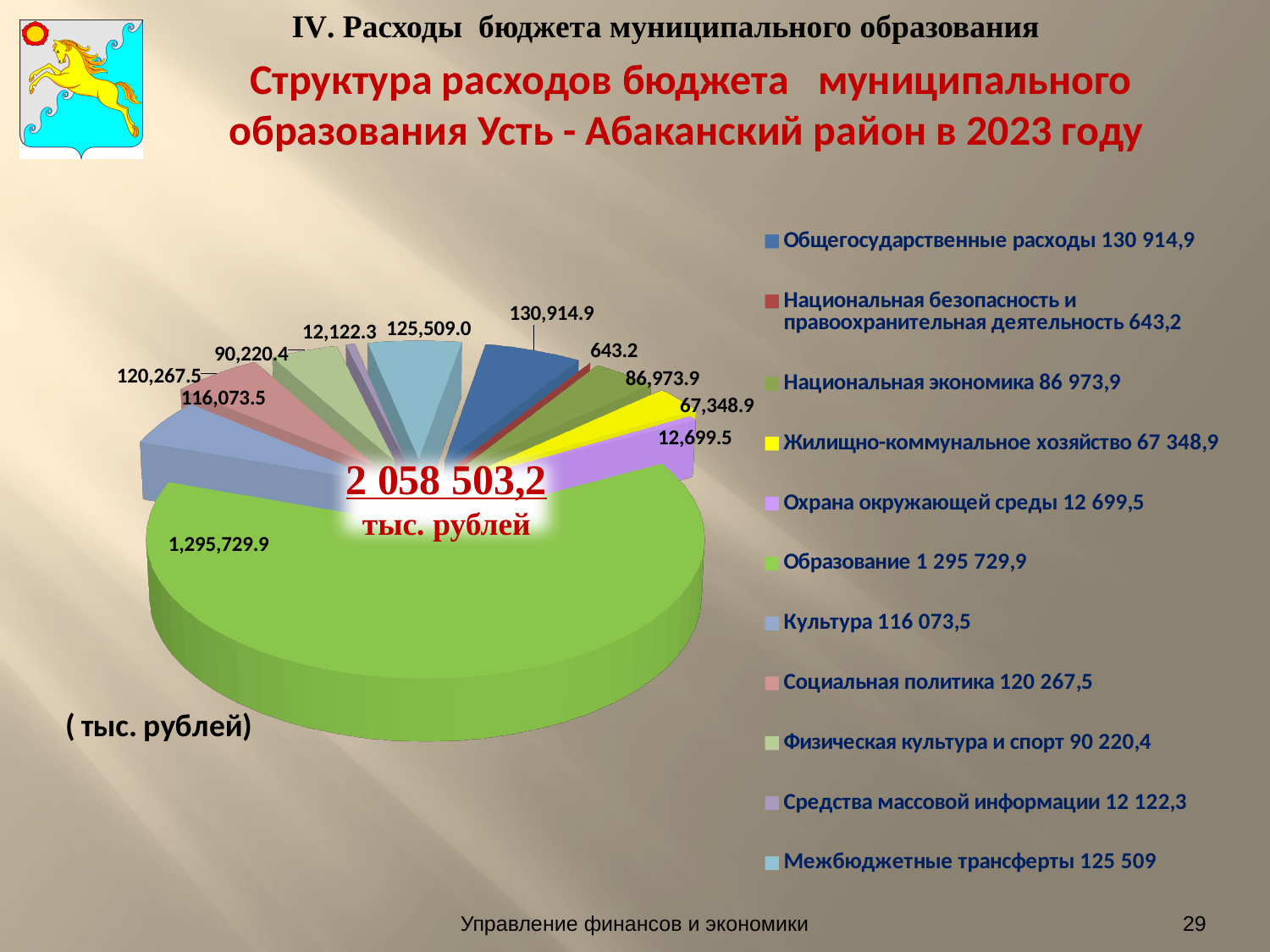
What is the difference between Социальная политика and Культура? 4,194.0 How many categories does the pie chart have? 11 What is the value for Жилищно-коммунальное хозяйство? 67,348.9 Which is larger, Физическая культура и спорт or Национальная экономика? Физическая культура и спорт What is the value for Национальная безопасность и правоохранительная деятельность? 643.2 Which category has the smallest value? Национальная безопасность и правоохранительная деятельность What is the value for Средства массовой информации? 12,122.3 What is the value for Образование? 1,295,729.9 What total is printed in the centre of the pie chart? 2 058 503,2 тыс. рублей What kind of chart is shown on the slide? pie chart What is the difference between Общегосударственные расходы and Межбюджетные трансферты? 5,405.9 Which category has the largest share of the pie? Образование